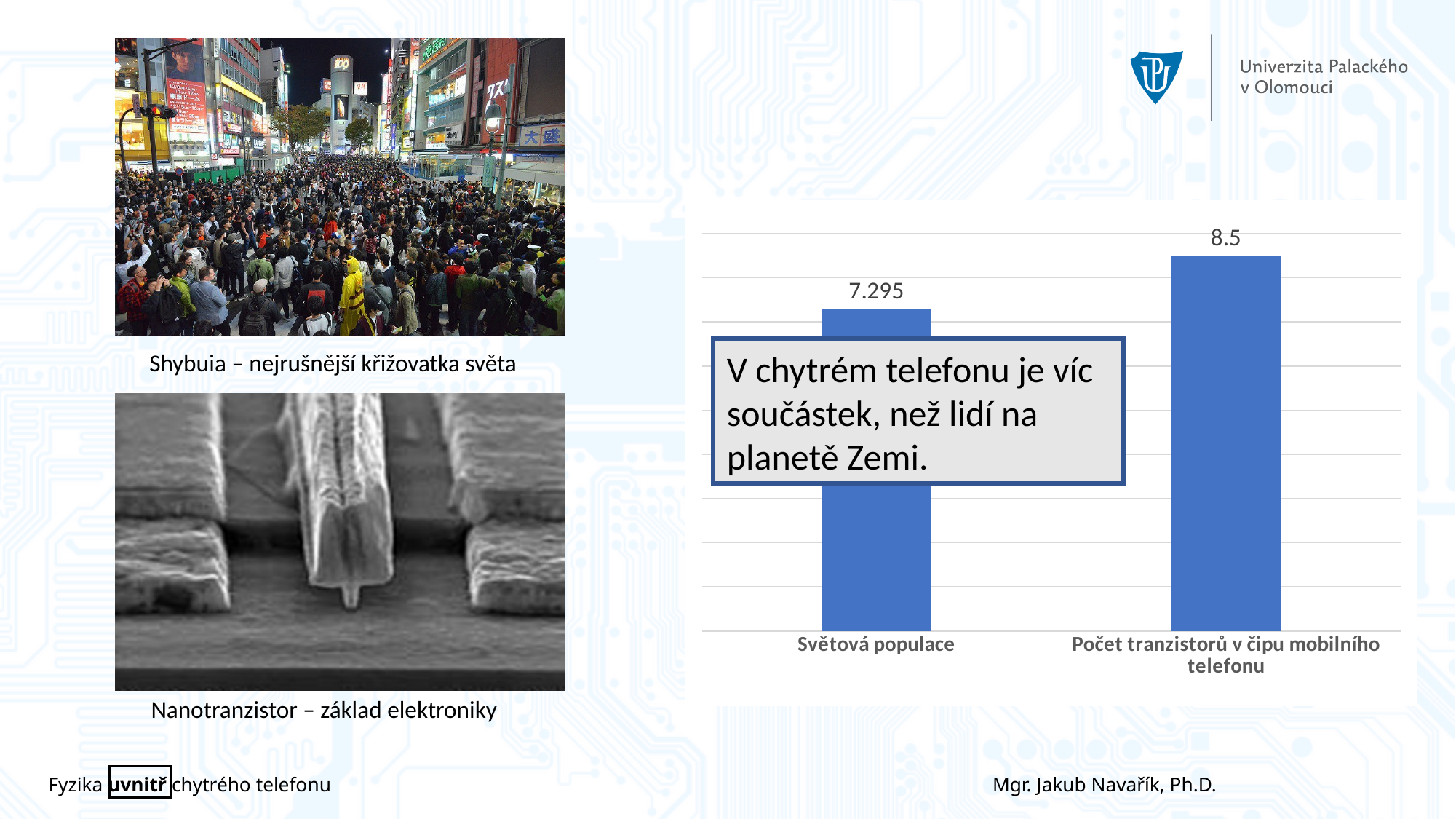
Which category has the highest value in the chart? Počet tranzistorů v čipu mobilního telefonu What is the difference between the value for Počet tranzistorů v čipu mobilního telefonu and the value for Světová populace? 1.205 What kind of chart is shown on the slide? Bar chart What is the value shown for Světová populace? 7.295 Which category has the lowest value in the chart? Světová populace How many categories are plotted in the chart? 2 What text is shown in the box overlaid on the chart? V chytrém telefonu je víc součástek, než lidí na planetě Zemi. Do the values rise or fall from left to right across the categories? Rise Which is larger: the value for Světová populace or the value for Počet tranzistorů v čipu mobilního telefonu? Počet tranzistorů v čipu mobilního telefonu What colour are the bars in the chart? Blue What is the value shown for Počet tranzistorů v čipu mobilního telefonu? 8.5